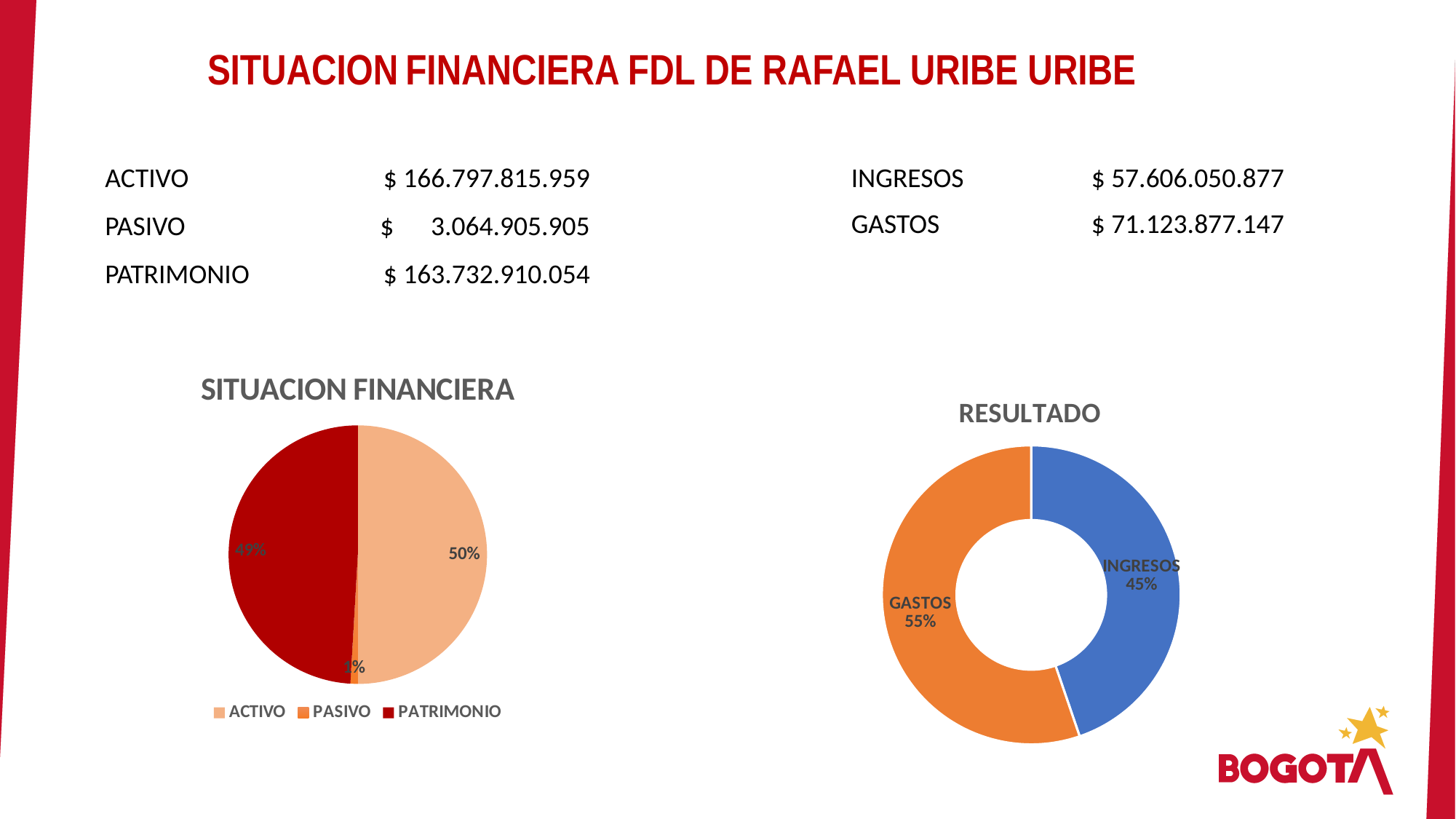
In the SITUACION FINANCIERA chart, what share does PASIVO have? 1% In the RESULTADO chart, what is the difference in percentage points between GASTOS and INGRESOS? 10 percentage points In the SITUACION FINANCIERA chart, what share does PATRIMONIO have? 49% In the RESULTADO chart, what share does INGRESOS have? 45% In the RESULTADO chart, which is larger, INGRESOS or GASTOS? GASTOS In the SITUACION FINANCIERA chart, which category has the smallest slice? PASIVO How many slices does the RESULTADO chart have? 2 What kind of chart is the SITUACION FINANCIERA chart? Pie chart In the SITUACION FINANCIERA chart, what colour is the PATRIMONIO slice? Dark red In the SITUACION FINANCIERA chart, how many categories does the legend list? 3